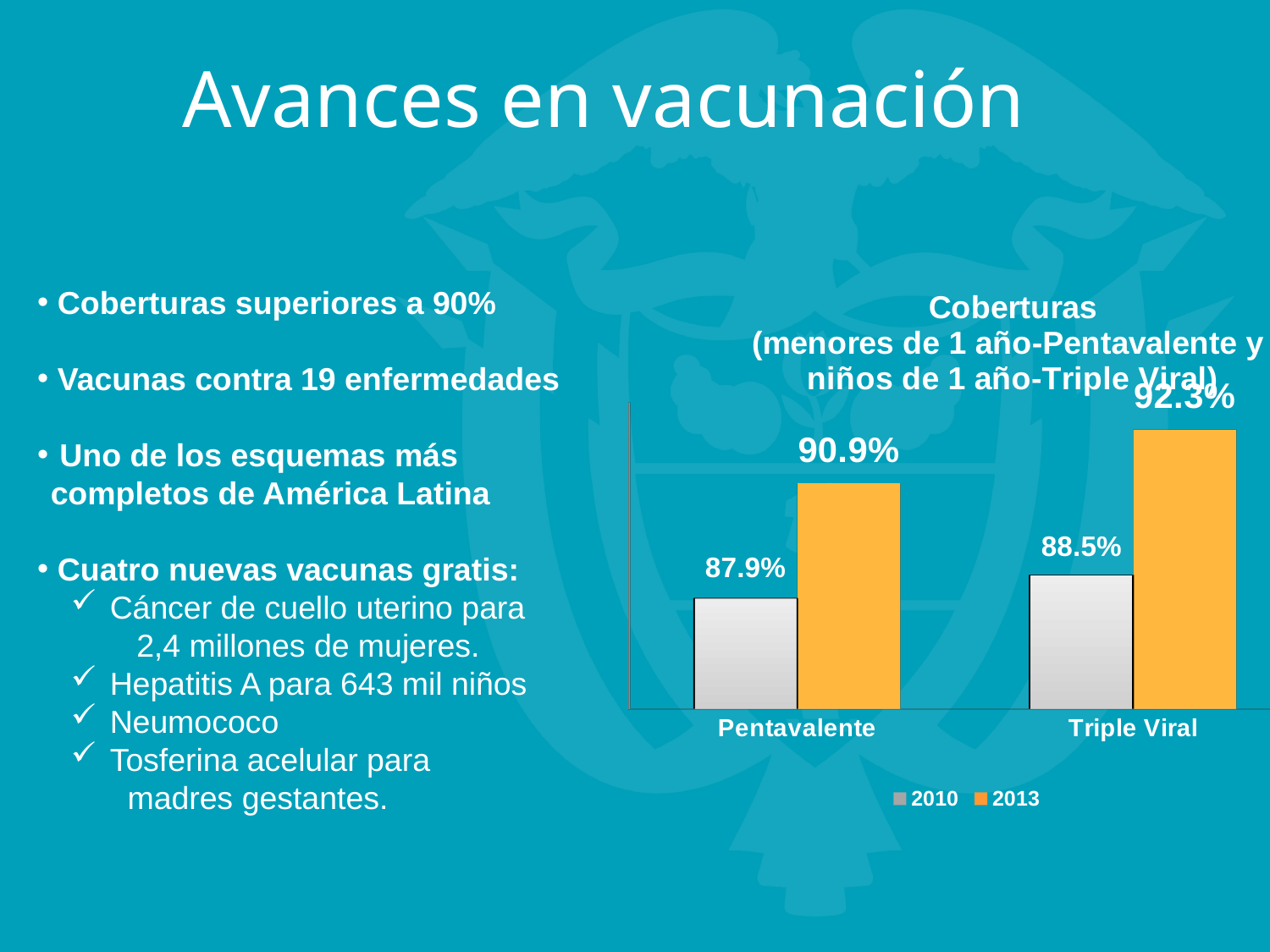
Which is larger: the 2013 value for Pentavalente or the 2013 value for Triple Viral? Triple Viral Which bar in the chart has the lowest value? Pentavalente 2010 How many series does the chart legend list? 2 Which bar in the chart has the highest value? Triple Viral 2013 What kind of chart is shown on the slide? Bar chart How many categories are shown on the x axis of the chart? 2 By how many percentage points did Pentavalente coverage increase from 2010 to 2013? 3.0 What is the 2013 coverage value for Triple Viral? 92.3% What is the 2010 coverage value for Triple Viral? 88.5% By how many percentage points did Triple Viral coverage increase from 2010 to 2013? 3.8 What is the 2013 coverage value for Pentavalente? 90.9% What is the 2010 coverage value for Pentavalente? 87.9%